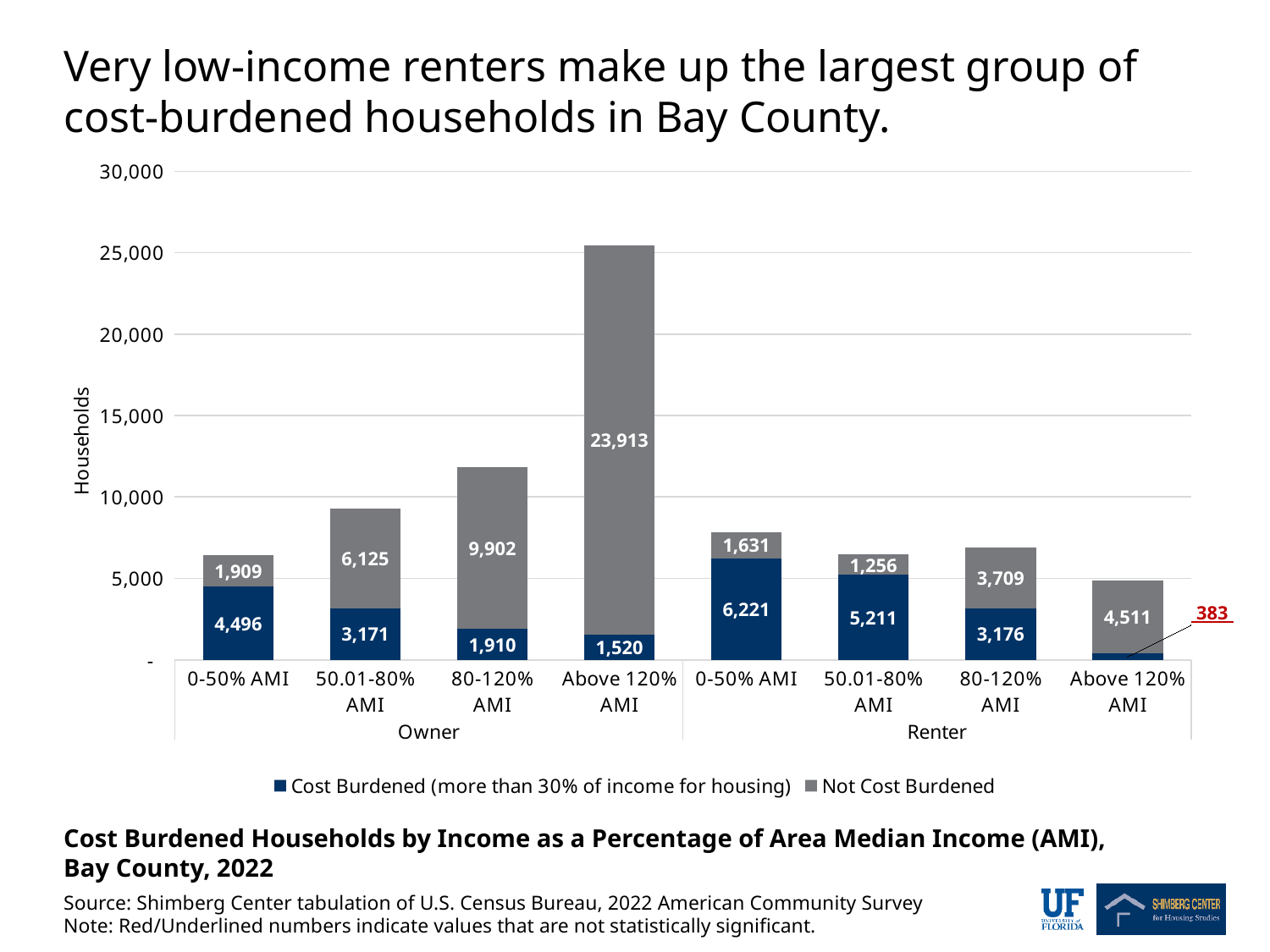
What is the number of not cost-burdened owner households in the Above 120% AMI category? 23,913 What is the number of cost-burdened renter households in the 0-50% AMI category? 6,221 What type of chart is shown on the slide? Stacked bar chart Is the total height of the Owner Above 120% AMI bar greater or less than 25,000? greater How many series does the legend list? 2 Which is larger: the number of cost-burdened owner households at 50.01-80% AMI or the number of cost-burdened renter households at 50.01-80% AMI? Renter (5,211) What is the difference between cost-burdened renter households and cost-burdened owner households in the 0-50% AMI category? 1,725 How many income categories are shown across both the Owner and Renter groups? 8 Which category has the highest number of cost-burdened households? Renter, 0-50% AMI What is the number of cost-burdened owner households in the 80-120% AMI category? 1,910 Which category has the lowest number of cost-burdened households? Renter, Above 120% AMI What is the total number of households in the Renter 0-50% AMI bar? 7,852